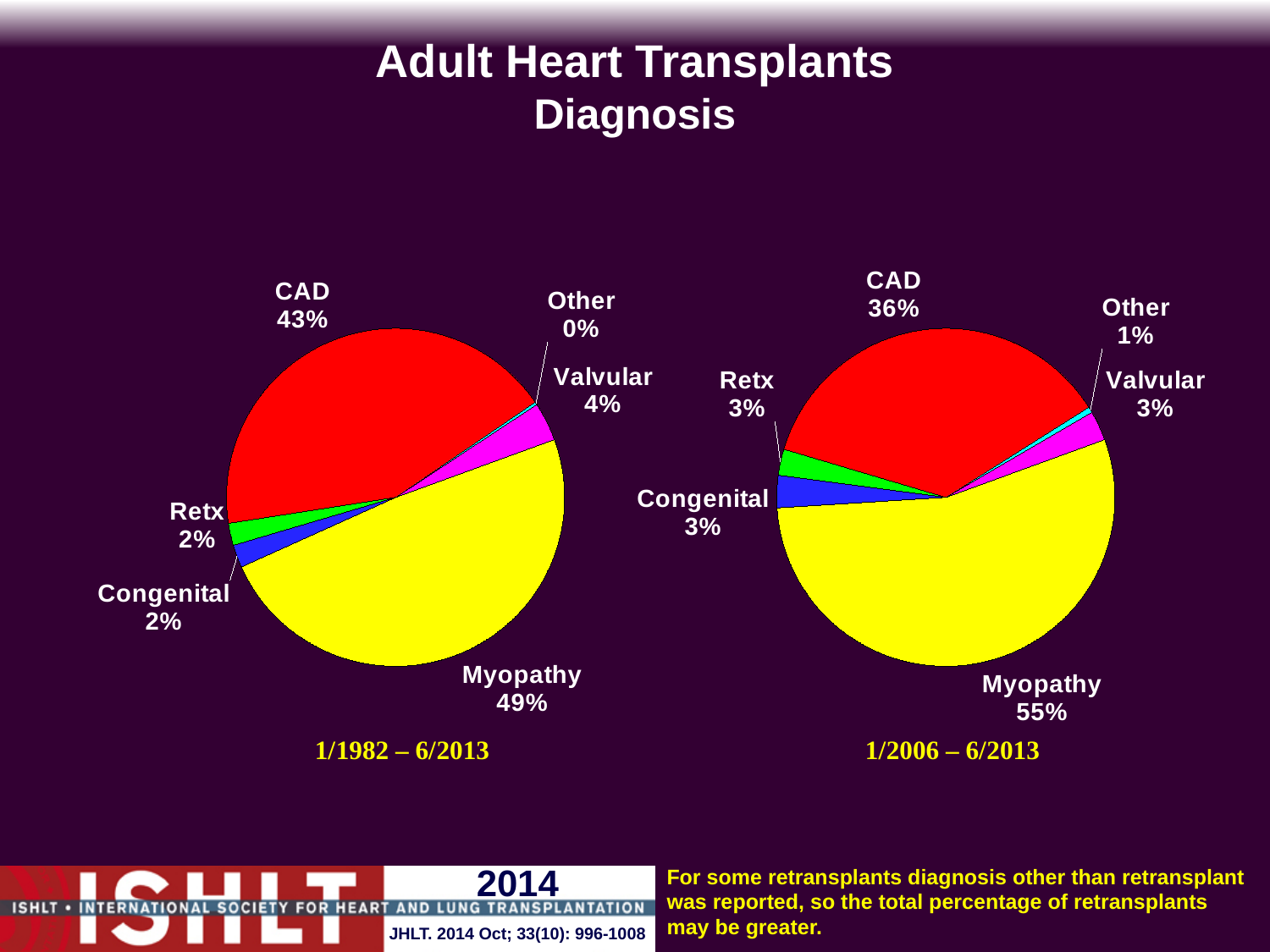
In the 1/1982 – 6/2013 pie chart, what percentage is labelled for CAD? 43% In the 1/2006 – 6/2013 pie chart, is the share for Retx larger or smaller than the share for Other? larger What colour is the Myopathy slice in both pie charts? Yellow How many diagnosis categories are labelled in the 1/1982 – 6/2013 pie chart? 6 In the 1/2006 – 6/2013 pie chart, what percentage is labelled for Myopathy? 55% In the 1/2006 – 6/2013 pie chart, what percentage is labelled for Valvular? 3% In the 1/1982 – 6/2013 pie chart, which diagnosis has the largest share? Myopathy Which chart shows a larger share for Myopathy, the 1/1982 – 6/2013 chart or the 1/2006 – 6/2013 chart? 1/2006 – 6/2013 In the 1/2006 – 6/2013 pie chart, what is the difference between the Myopathy and CAD percentages? 19% In the 1/1982 – 6/2013 pie chart, what is the difference between the Myopathy and CAD percentages? 6% What type of chart is used on this slide? Pie chart In the 1/2006 – 6/2013 pie chart, which diagnosis has the smallest share? Other